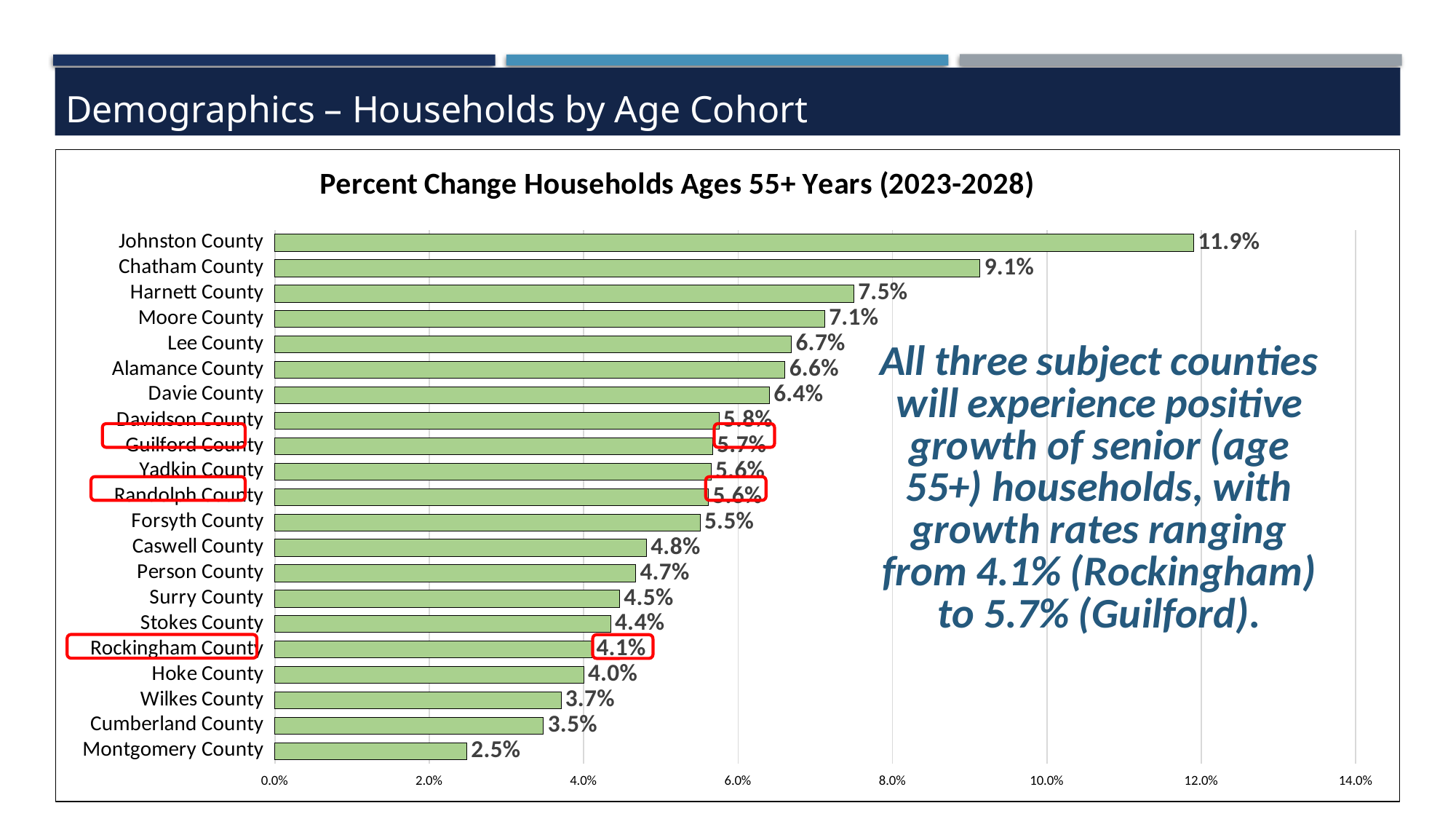
What is the difference between the values for Johnston County and Chatham County? 2.8% What is the value shown for Rockingham County? 4.1% What is the percent change in households ages 55+ for Johnston County? 11.9% Which county has the lowest percent change in households ages 55+? Montgomery County What is the title of the chart? Percent Change Households Ages 55+ Years (2023-2028) Which county has the highest percent change in households ages 55+? Johnston County Which has a larger value, Harnett County or Moore County? Harnett County How many counties are shown in the chart? 21 What is the difference between the values for Guilford County and Rockingham County? 1.6% What is the value shown for Guilford County? 5.7% What type of chart is shown on the slide? Bar chart Is the value for Chatham County greater or less than 8.0%? greater